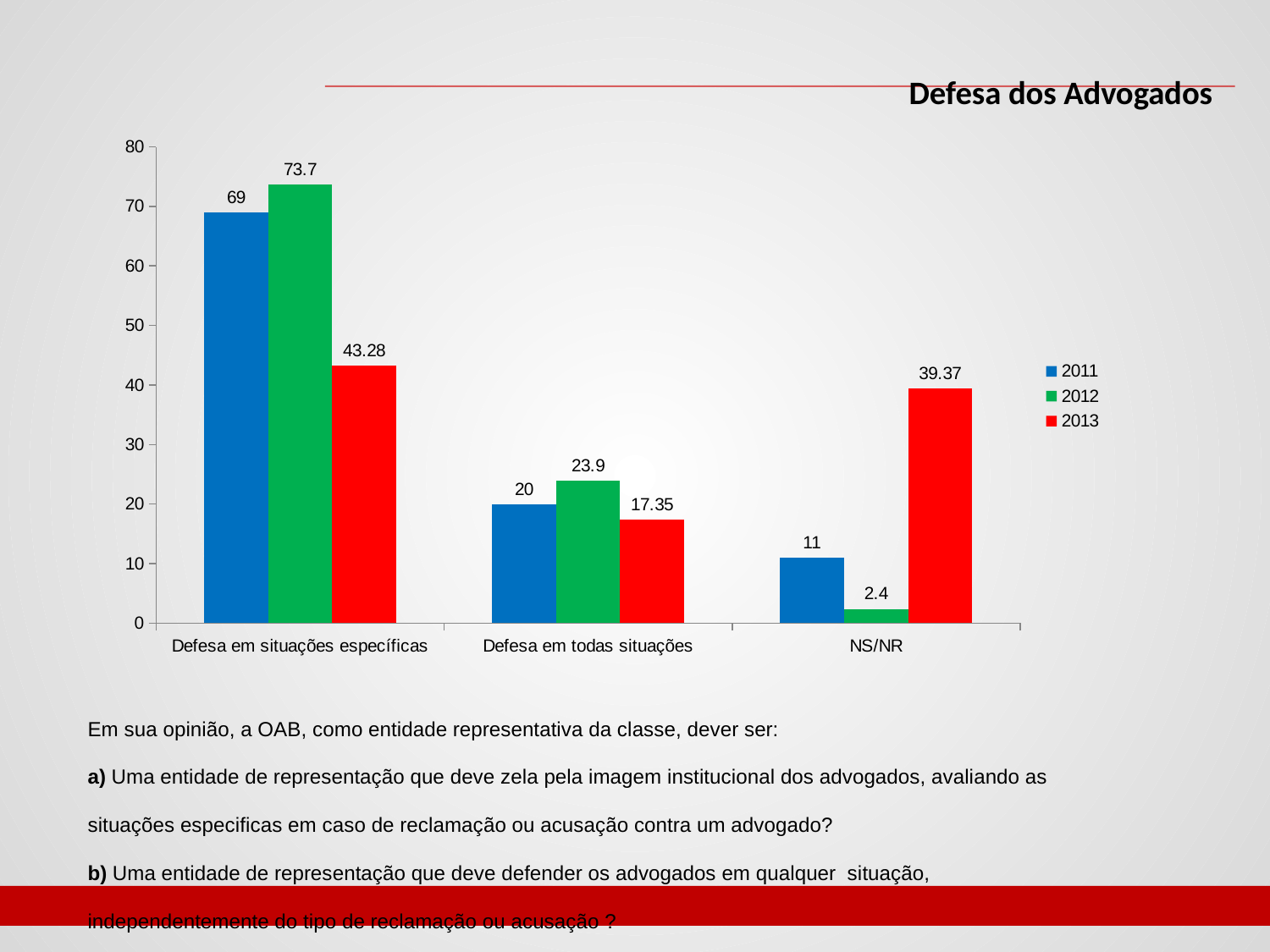
Which is larger in the 'Defesa em todas situações' category: the 2012 value or the 2013 value? 2012 What is the value for 2012 in the 'Defesa em situações específicas' category? 73.7 What kind of chart is shown on the slide? bar chart What is the value for 2013 in the 'NS/NR' category? 39.37 What is the difference between the 2012 and 2011 values in the 'Defesa em situações específicas' category? 4.7 Which category has the highest value for the 2013 series? Defesa em situações específicas What is the value for 2011 in the 'Defesa em todas situações' category? 20 Which category has the lowest value for the 2012 series? NS/NR Is the value for 2013 in 'Defesa em situações específicas' greater or less than 40? greater What is the title of the chart? Defesa dos Advogados How many series does the legend list? 3 How many categories are shown on the x axis? 3